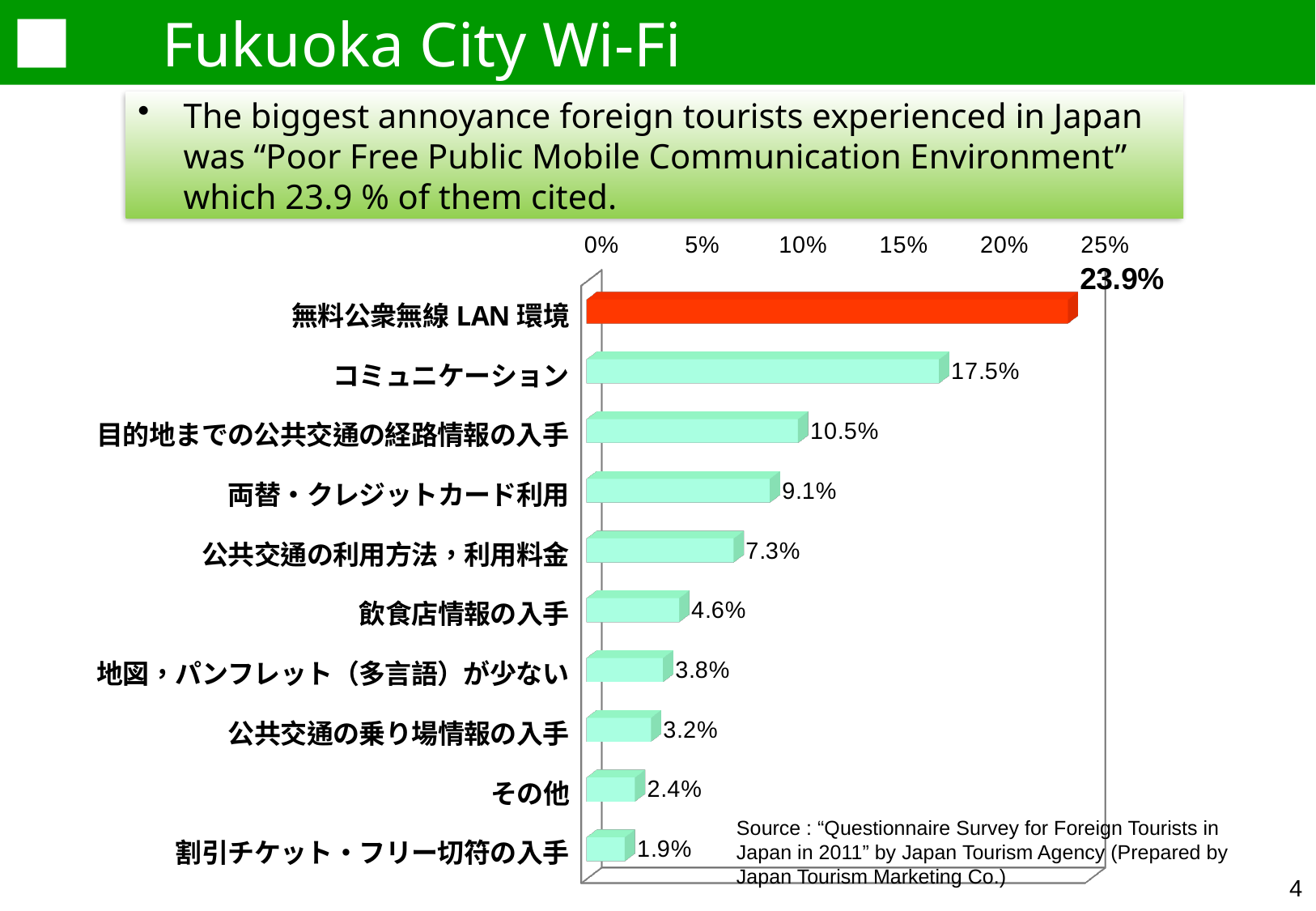
Is the value for 目的地までの公共交通の経路情報の入手 greater or less than 10%? greater How many categories are shown in the chart? 10 What is the value for 無料公衆無線 LAN 環境? 23.9% What is the value for 両替・クレジットカード利用? 9.1% Which category has the highest value? 無料公衆無線 LAN 環境 What kind of chart is shown on the slide? Bar chart Which is larger, the value for 飲食店情報の入手 or the value for 公共交通の乗り場情報の入手? 飲食店情報の入手 Which bar is coloured differently (red) from the others? 無料公衆無線 LAN 環境 What is the difference between the values for 無料公衆無線 LAN 環境 and コミュニケーション? 6.4% What is the value for その他? 2.4% What is the value for コミュニケーション? 17.5% Which category has the lowest value? 割引チケット・フリー切符の入手